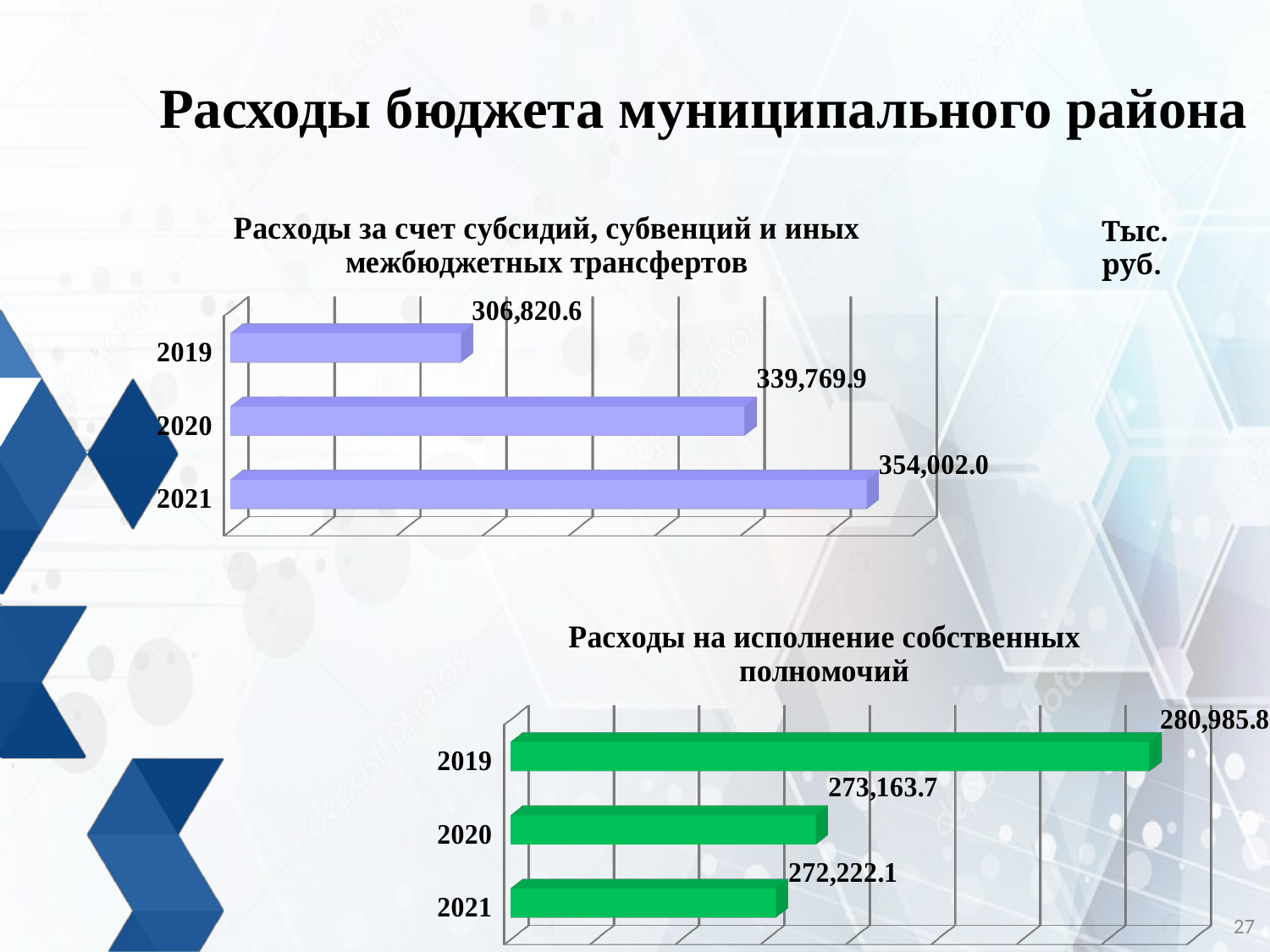
In the chart 'Расходы за счет субсидий, субвенций и иных межбюджетных трансфертов', what is the value for 2019? 306,820.6 In the chart 'Расходы на исполнение собственных полномочий', do the values rise or fall from 2019 to 2021? Fall In the chart 'Расходы на исполнение собственных полномочий', what is the value for 2021? 272,222.1 In the chart 'Расходы на исполнение собственных полномочий', what is the value for 2019? 280,985.8 In the chart 'Расходы за счет субсидий, субвенций и иных межбюджетных трансфертов', which year has the highest value? 2021 What kind of chart is 'Расходы на исполнение собственных полномочий'? Bar chart In the chart 'Расходы на исполнение собственных полномочий', which is larger: the value for 2020 or the value for 2021? 2020 In the chart 'Расходы за счет субсидий, субвенций и иных межбюджетных трансфертов', what is the value for 2020? 339,769.9 In the chart 'Расходы на исполнение собственных полномочий', what is the difference between the 2019 and 2021 values? 8,763.7 In the chart 'Расходы за счет субсидий, субвенций и иных межбюджетных трансфертов', what is the difference between the 2021 and 2019 values? 47,181.4 How many years are shown in the chart 'Расходы за счет субсидий, субвенций и иных межбюджетных трансфертов'? 3 In the chart 'Расходы на исполнение собственных полномочий', which year has the lowest value? 2021